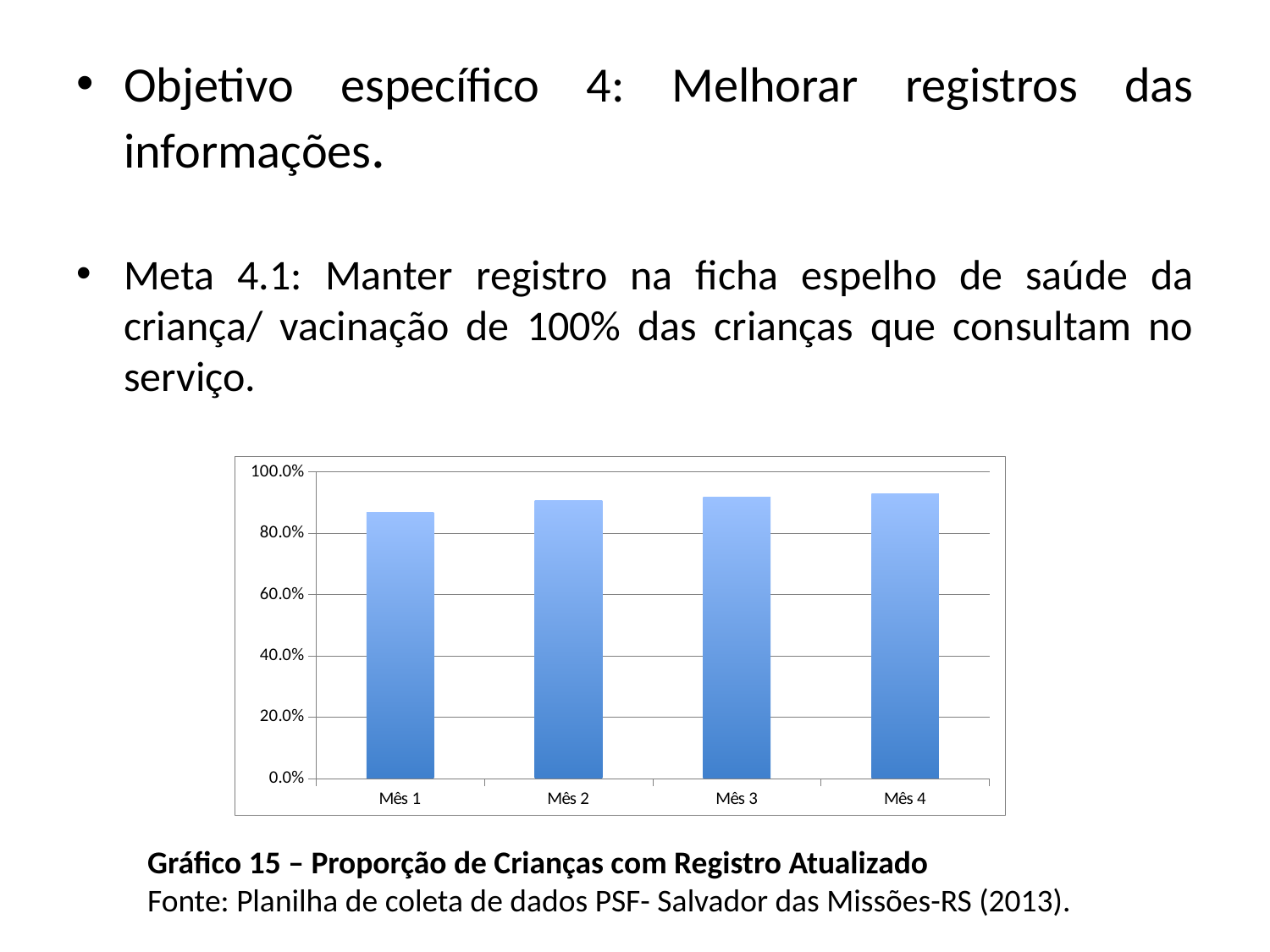
Which month has the lowest bar in the chart? Mês 1 What kind of chart is shown on the slide? bar chart Is the value for Mês 3 greater or less than 80.0%? greater What is the highest tick value shown on the y axis of the chart? 100.0% Which is larger, the value for Mês 1 or the value for Mês 2? Mês 2 Is the value for Mês 1 greater or less than 80.0%? greater Do the values rise or fall from Mês 1 to Mês 4? rise Which is larger, the value for Mês 1 or the value for Mês 4? Mês 4 Is the value for Mês 4 greater or less than 100.0%? less What is the title given for the chart in the caption below it? Gráfico 15 – Proporção de Crianças com Registro Atualizado How many categories (months) are shown on the x axis of the chart? 4